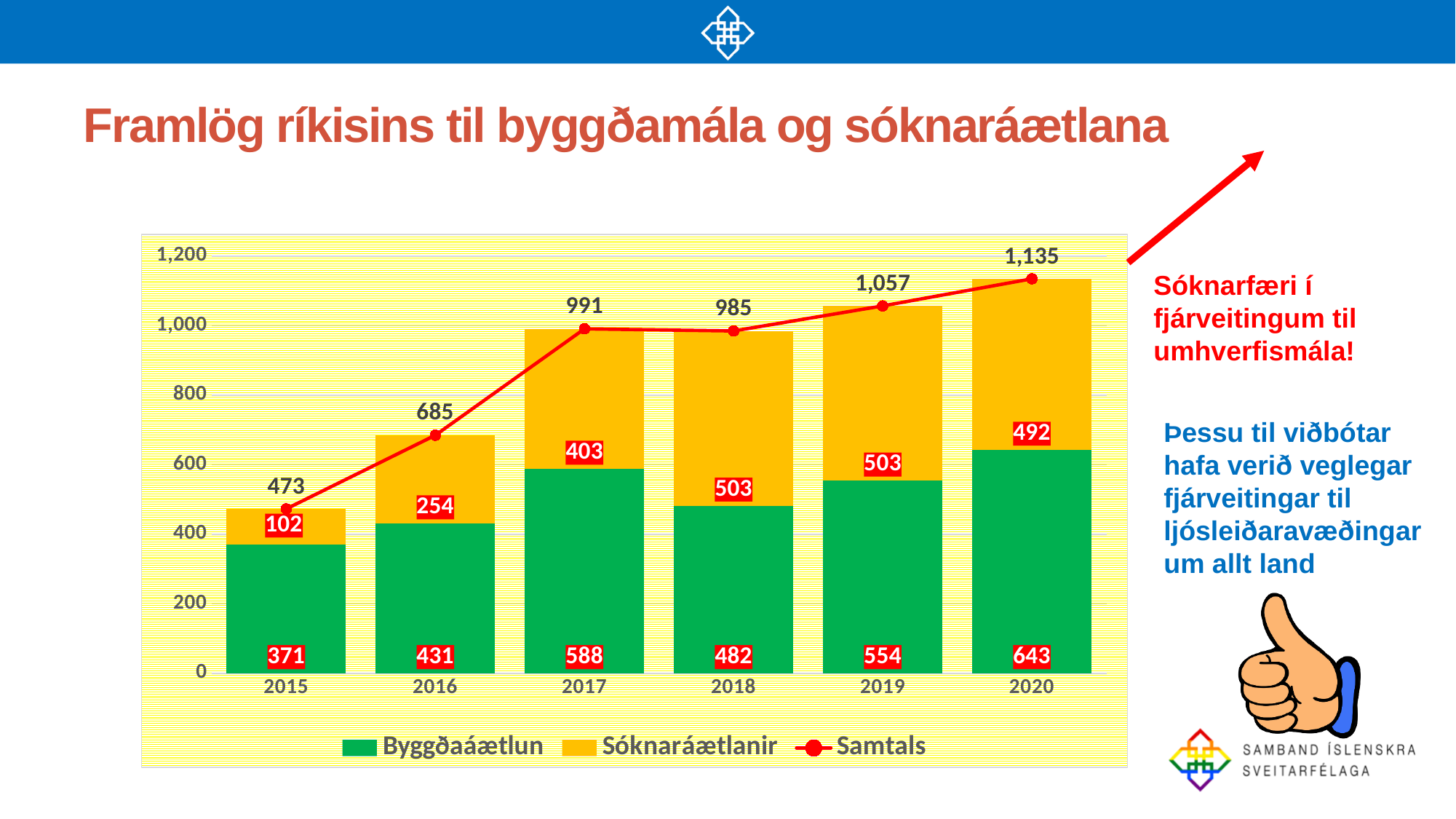
What kind of chart is shown on the slide? Stacked bar chart with a line Does the Samtals line generally rise or fall from 2015 to 2020? Rise What is the difference between the Byggðaáætlun values for 2020 and 2015? 272 What is the total of the stacked bar for 2018? 985 Which year has the lowest Sóknaráætlanir value? 2015 How many series does the legend list? 3 How many years are shown on the x axis? 6 Which is larger, the Sóknaráætlanir value for 2018 or for 2020? 2018 What is the value of Sóknaráætlanir for 2016? 254 What is the Samtals value for 2019? 1,057 What is the value of Byggðaáætlun for 2017? 588 Which year has the highest Samtals value? 2020